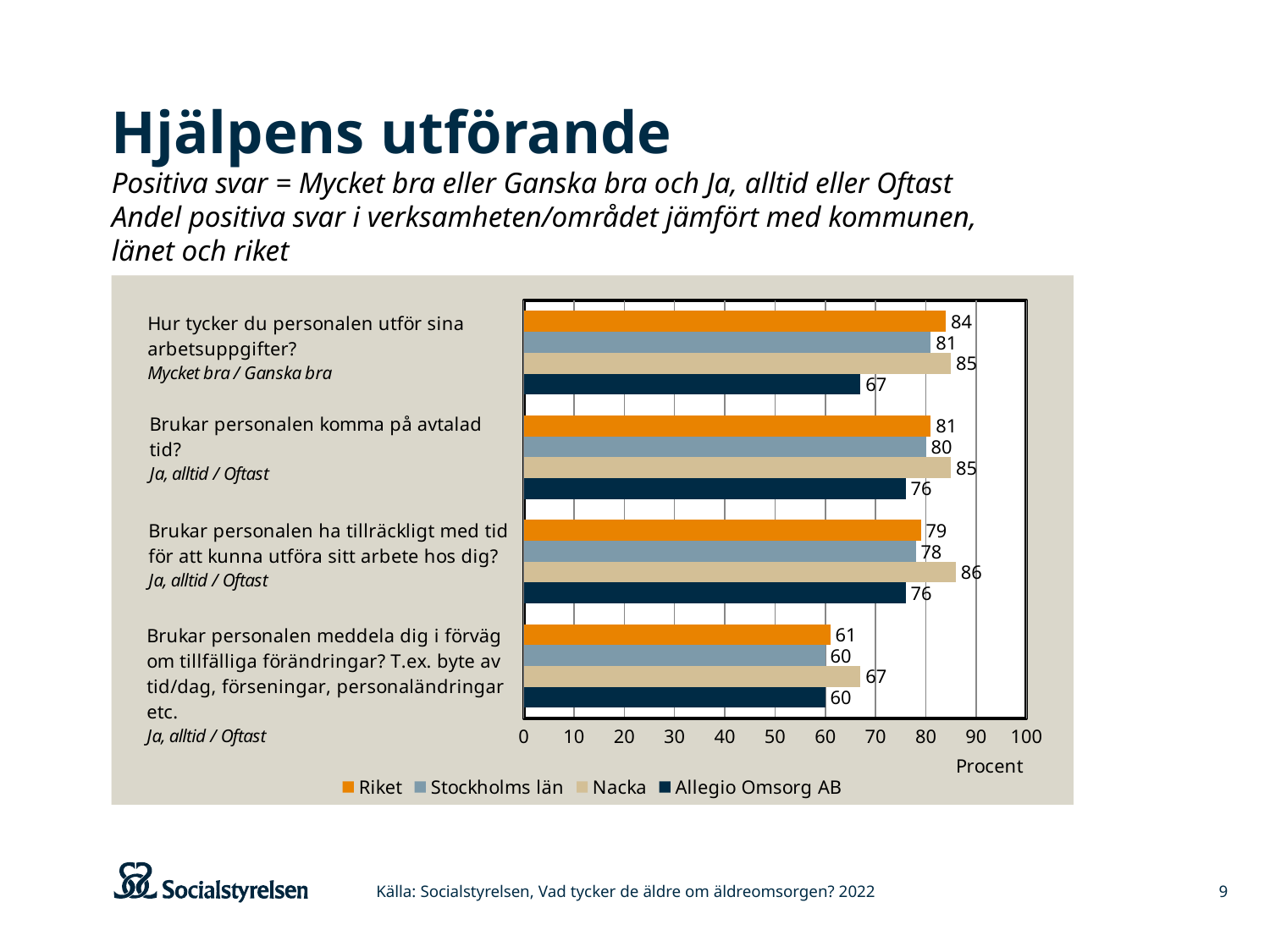
What is the value for Nacka on the question "Hur tycker du personalen utför sina arbetsuppgifter?"? 85 What is the value for Allegio Omsorg AB on the question "Brukar personalen komma på avtalad tid?"? 76 What kind of chart is shown on the slide? Bar chart Which is larger on the question "Brukar personalen komma på avtalad tid?": Riket or Allegio Omsorg AB? Riket What is the value for Stockholms län on the question "Brukar personalen ha tillräckligt med tid för att kunna utföra sitt arbete hos dig?"? 78 How many question categories are shown in the chart? 4 What is the value for Riket on the question "Brukar personalen meddela dig i förväg om tillfälliga förändringar?"? 61 Is the value for Nacka on the question "Brukar personalen meddela dig i förväg om tillfälliga förändringar?" greater or less than 70? less How many series does the legend list? 4 Which series has the highest value on the question "Brukar personalen ha tillräckligt med tid för att kunna utföra sitt arbete hos dig?"? Nacka Which series has the lowest value on the question "Hur tycker du personalen utför sina arbetsuppgifter?"? Allegio Omsorg AB What is the difference between Nacka and Allegio Omsorg AB on the question "Hur tycker du personalen utför sina arbetsuppgifter?"? 18